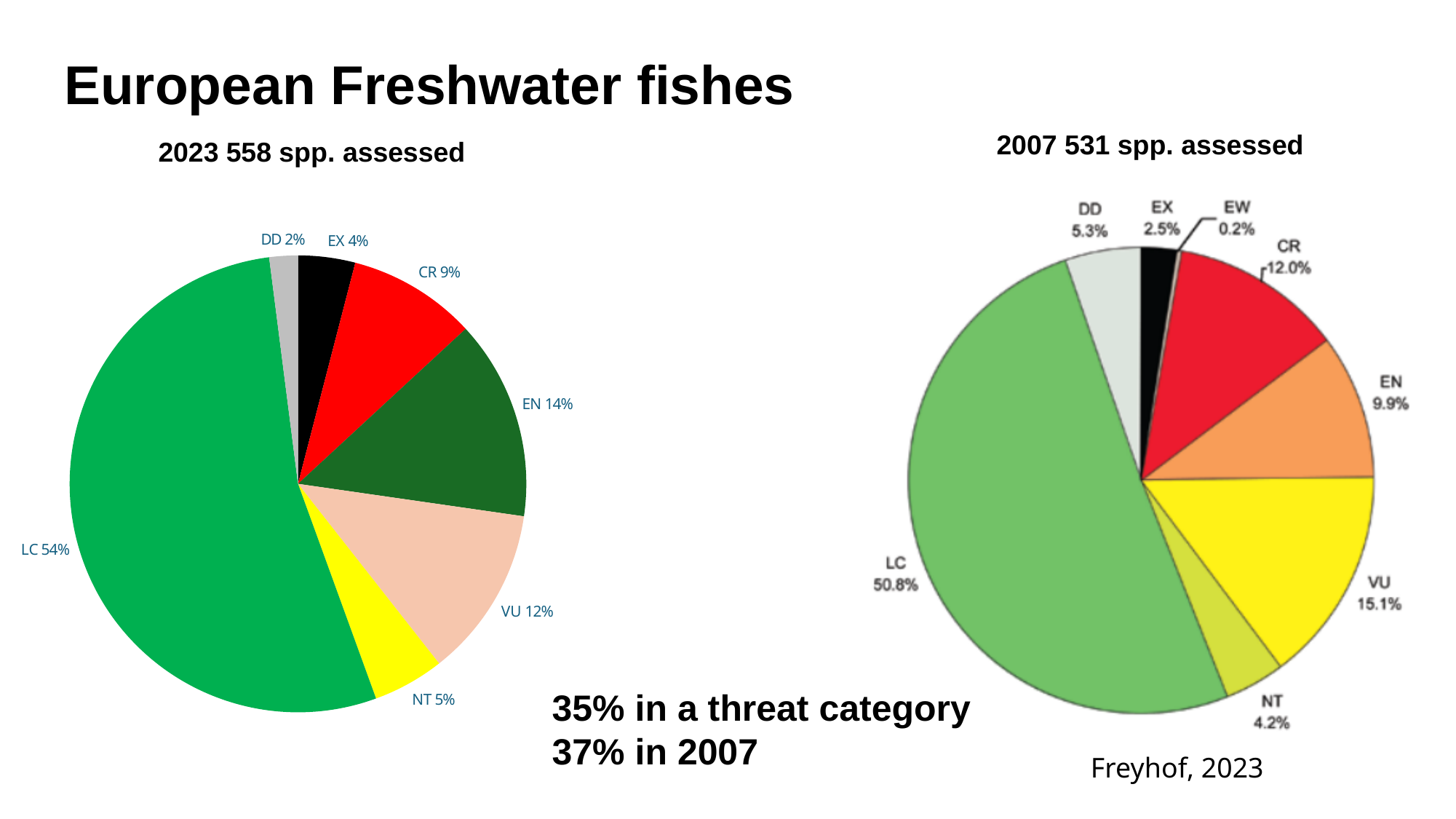
In the 2007 pie chart (right), which category has the smallest share? EW In the 2007 pie chart (right), which is larger, the DD share or the EX share? DD In the 2007 pie chart (right), what is the difference between the CR share and the EN share? 2.1% In the 2023 pie chart (left), what share of species is in the LC category? 54% How many categories are shown in the 2007 pie chart (right)? 8 How many categories are shown in the 2023 pie chart (left)? 7 In the 2023 pie chart (left), which category has the largest share? LC In the 2007 pie chart (right), what share of species is in the EX category? 2.5% What type of chart is used on the left for the 2023 assessment? Pie chart In the 2023 pie chart (left), which category has the smallest share? DD In the 2007 pie chart (right), what share of species is in the VU category? 15.1% In the 2023 pie chart (left), what is the difference between the EN share and the CR share? 5%